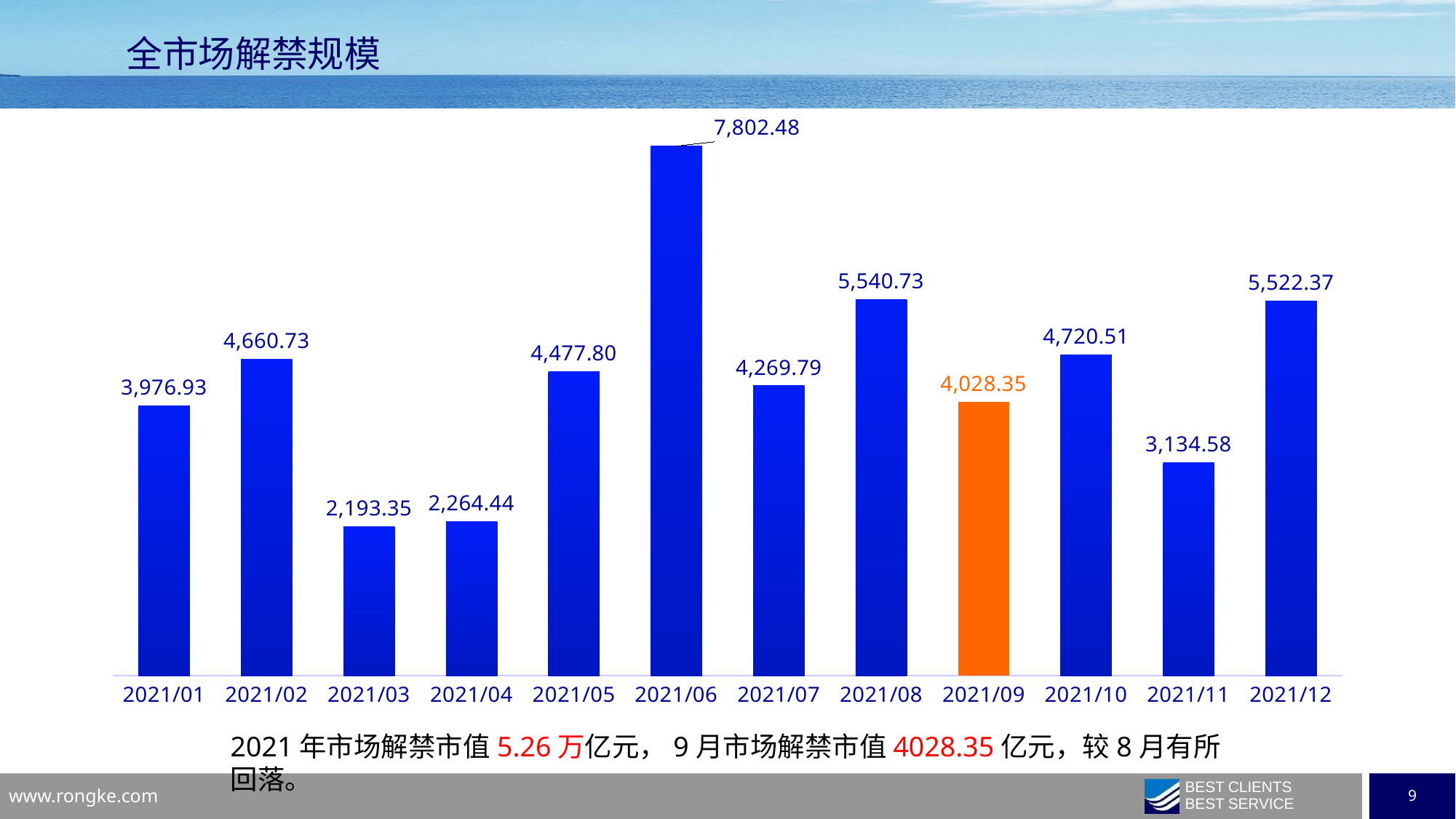
Which month's bar is coloured orange instead of blue? 2021/09 What is the difference between the values for 2021/08 and 2021/09? 1,512.38 Which is larger, the value for 2021/05 or the value for 2021/07? 2021/05 Which month has the highest value? 2021/06 What is the value for 2021/11? 3,134.58 What is the value for 2021/09? 4,028.35 What is the value for 2021/06? 7,802.48 What kind of chart is this? Bar chart Which month has the lowest value? 2021/03 What is the difference between the values for 2021/06 and 2021/03? 5,609.13 Do the values rise or fall from 2021/03 to 2021/06? Rise How many months are shown on the x axis? 12